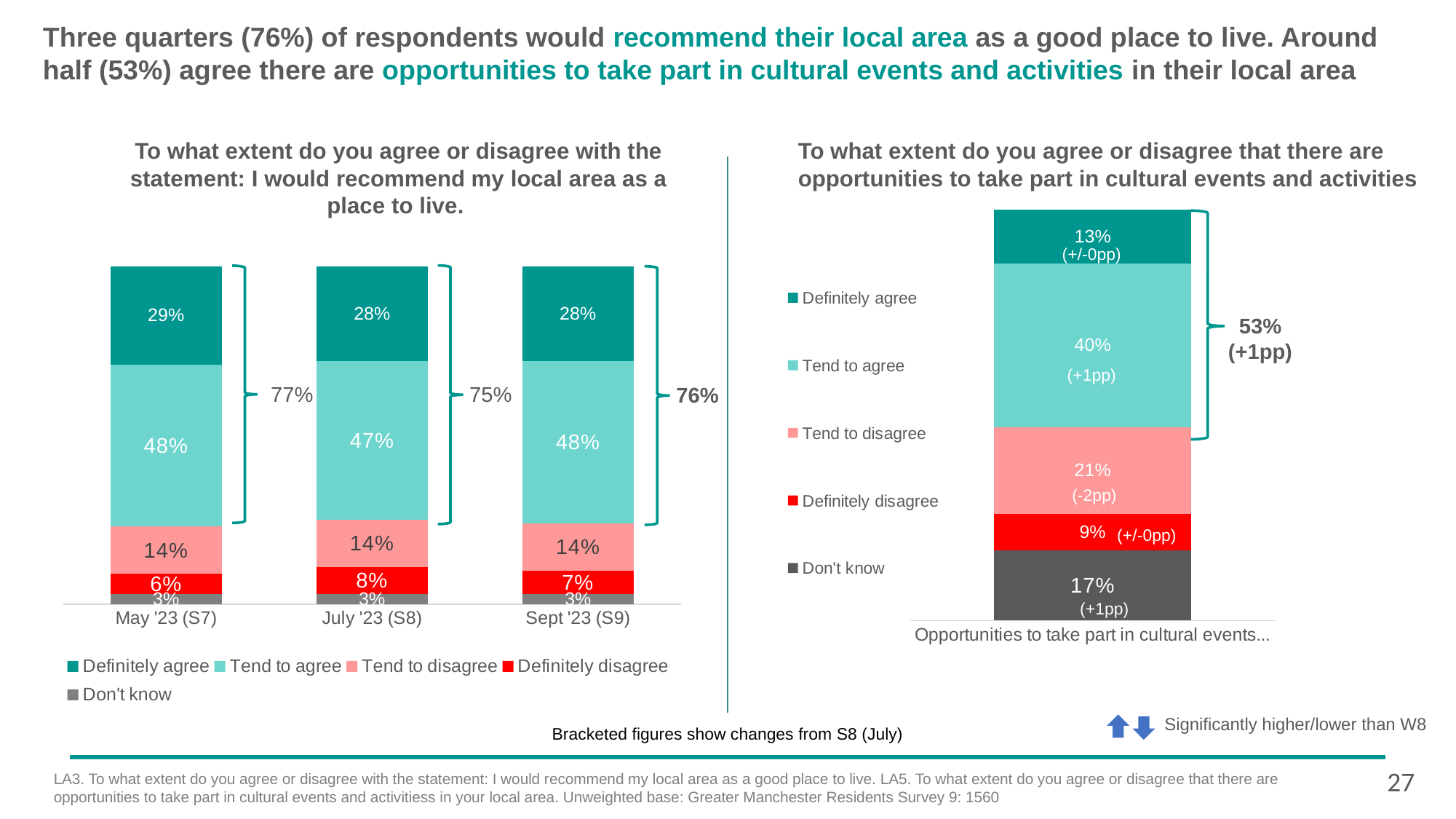
In the left chart (recommend my local area as a place to live), what is the difference between the 'Definitely agree' values for May '23 (S7) and Sept '23 (S9)? 1 percentage point In the left chart (recommend my local area as a place to live), what percentage said 'Definitely disagree' in July '23 (S8)? 8% In the right chart (opportunities to take part in cultural events and activities), what change from S8 is shown in brackets for 'Tend to disagree'? -2pp In the left chart (recommend my local area as a place to live), what percentage of respondents said 'Tend to agree' in Sept '23 (S9)? 48% In the right chart (opportunities to take part in cultural events and activities), what is the combined agree figure shown by the bracket? 53% In the left chart (recommend my local area as a place to live), what is the combined agree figure shown by the bracket for May '23 (S7)? 77% In the right chart (opportunities to take part in cultural events and activities), what percentage said 'Tend to agree'? 40% In the left chart (recommend my local area as a place to live), how many survey waves are shown on the x axis? 3 In the right chart (opportunities to take part in cultural events and activities), which response category has the lowest percentage? Definitely disagree In the left chart (recommend my local area as a place to live), which survey wave has the lowest combined agree figure shown by the brackets? July '23 (S8) What kind of chart is the left chart (recommend my local area as a place to live)? Stacked bar chart In the left chart (recommend my local area as a place to live), how many series does the legend list? 5